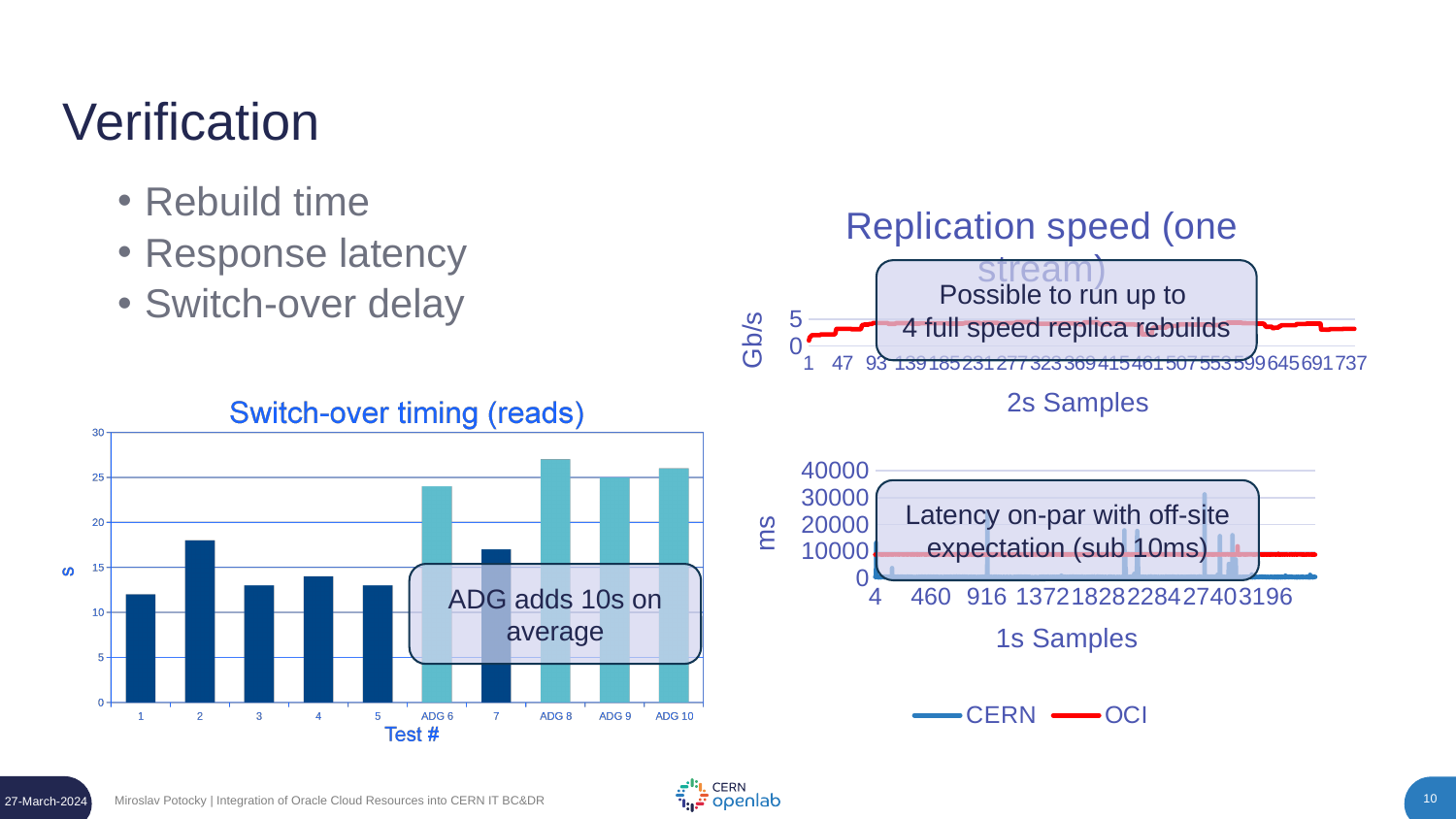
How many test categories are shown on the x axis of the 'Switch-over timing (reads)' chart? 10 What are the two series named in the legend of the latency chart (bottom right, ms axis)? CERN and OCI What is the x-axis title of the 'Replication speed (one stream)' chart? 2s Samples In the 'Switch-over timing (reads)' chart, is the value for test 1 greater or less than 15? less In the 'Switch-over timing (reads)' chart, is the value for ADG 8 greater or less than 25? greater In the 'Switch-over timing (reads)' chart, which is larger, the value for ADG 6 or the value for test 7? ADG 6 In the 'Switch-over timing (reads)' chart, is the value for test 7 greater or less than 20? less How many series does the legend of the latency chart (bottom right, ms axis) list? 2 What kind of chart is the 'Switch-over timing (reads)' chart? bar chart In the 'Switch-over timing (reads)' chart, which is larger, the value for test 2 or the value for test 1? test 2